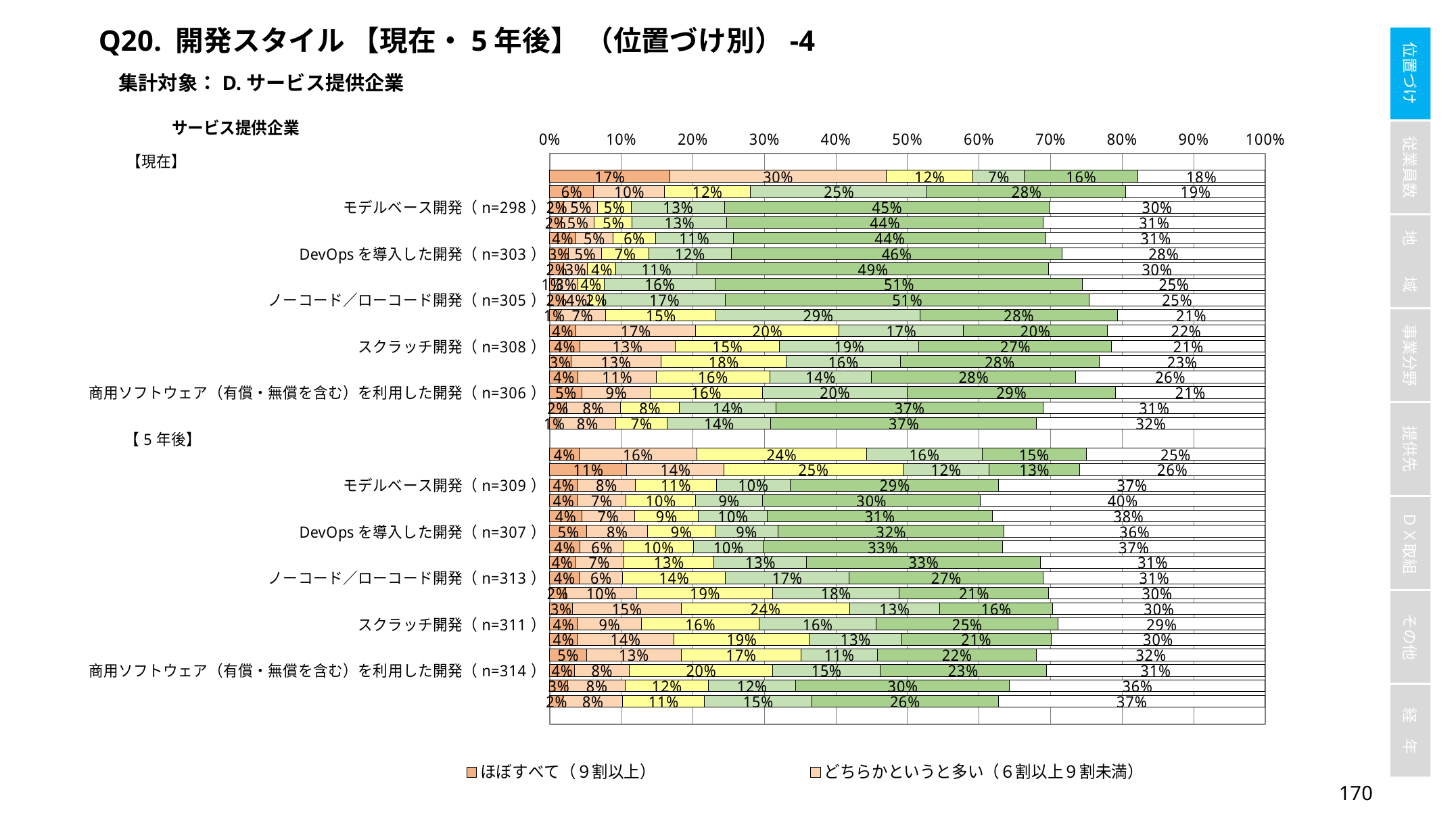
In the bottommost bar of the chart, what is the value of the rightmost segment? 37% What is the first legend entry shown below the chart? ほぼすべて（９割以上） In the topmost bar of the 【現在】 section, what is the value of the leftmost segment? 17% In the topmost bar of the 【5年後】 section, what is the value of the third segment (yellow)? 24% In the topmost bar of the 【5年後】 section, what is the value of the leftmost segment? 4% In the topmost bar of the 【現在】 section, what is the difference between the second segment (30%) and the first segment (17%)? 13 percentage points What is the sample size (n) shown for スクラッチ開発 in the 【5年後】 section? n=311 In the topmost bar of the 【現在】 section, what is the value of the rightmost segment? 18% What is the sample size (n) shown for DevOps を導入した開発 in the 【現在】 section? n=303 What is the second legend entry shown below the chart? どちらかというと多い（６割以上９割未満） What kind of chart is shown on the slide? bar chart